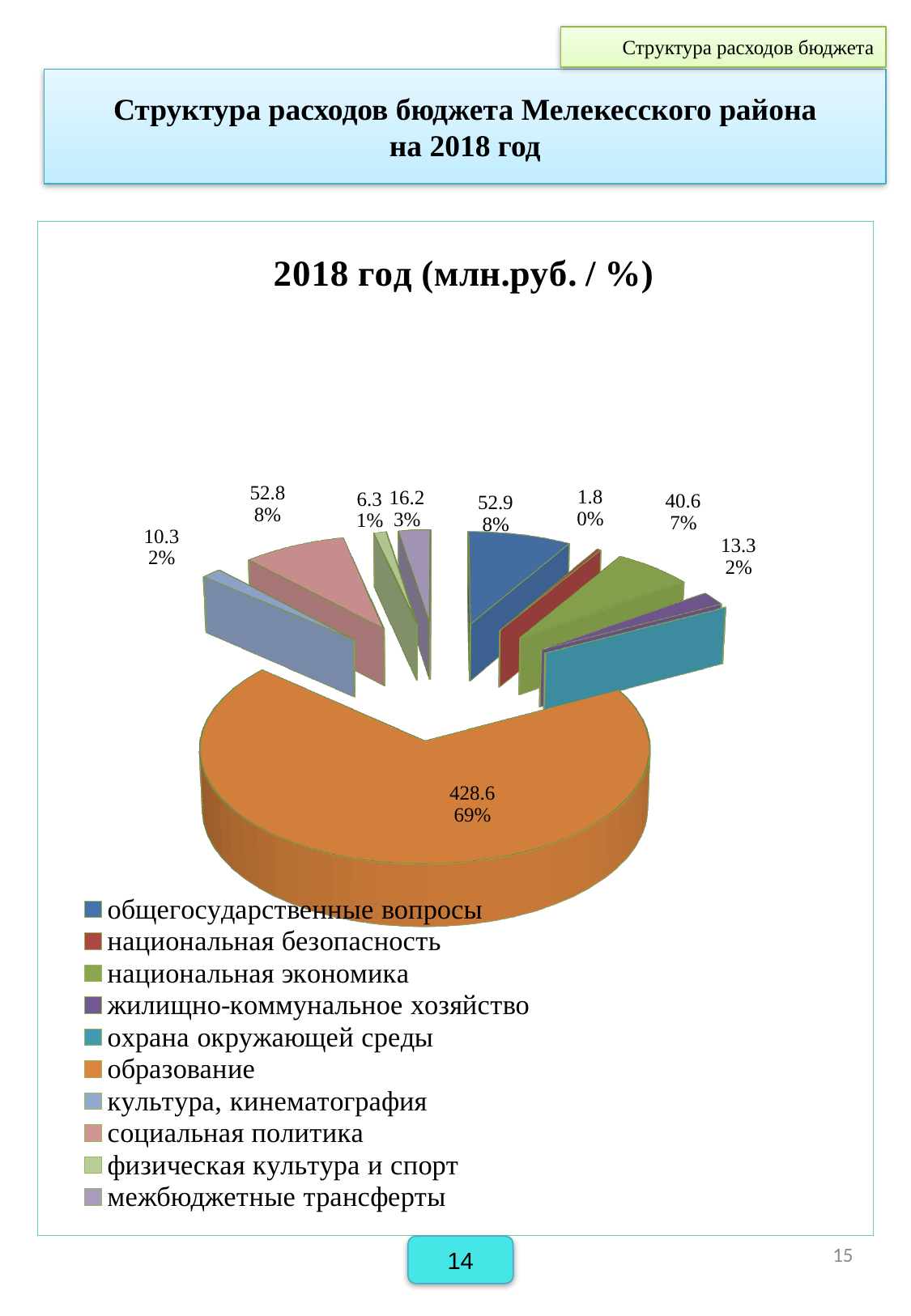
What kind of chart is shown on the slide? pie chart What is the title of the chart? 2018 год (млн.руб. / %) Which is larger, общегосударственные вопросы or национальная экономика? общегосударственные вопросы How many categories does the chart's legend list? 10 Which category has the largest slice of the pie? образование What value is shown for межбюджетные трансферты? 16.2 What share of the pie does образование take? 69% What value is shown for общегосударственные вопросы? 52.9 What share of the pie does социальная политика take? 8% What value is shown for национальная экономика? 40.6 What is the difference between the values for общегосударственные вопросы and национальная экономика? 12.3 What value in million rubles is shown for образование? 428.6